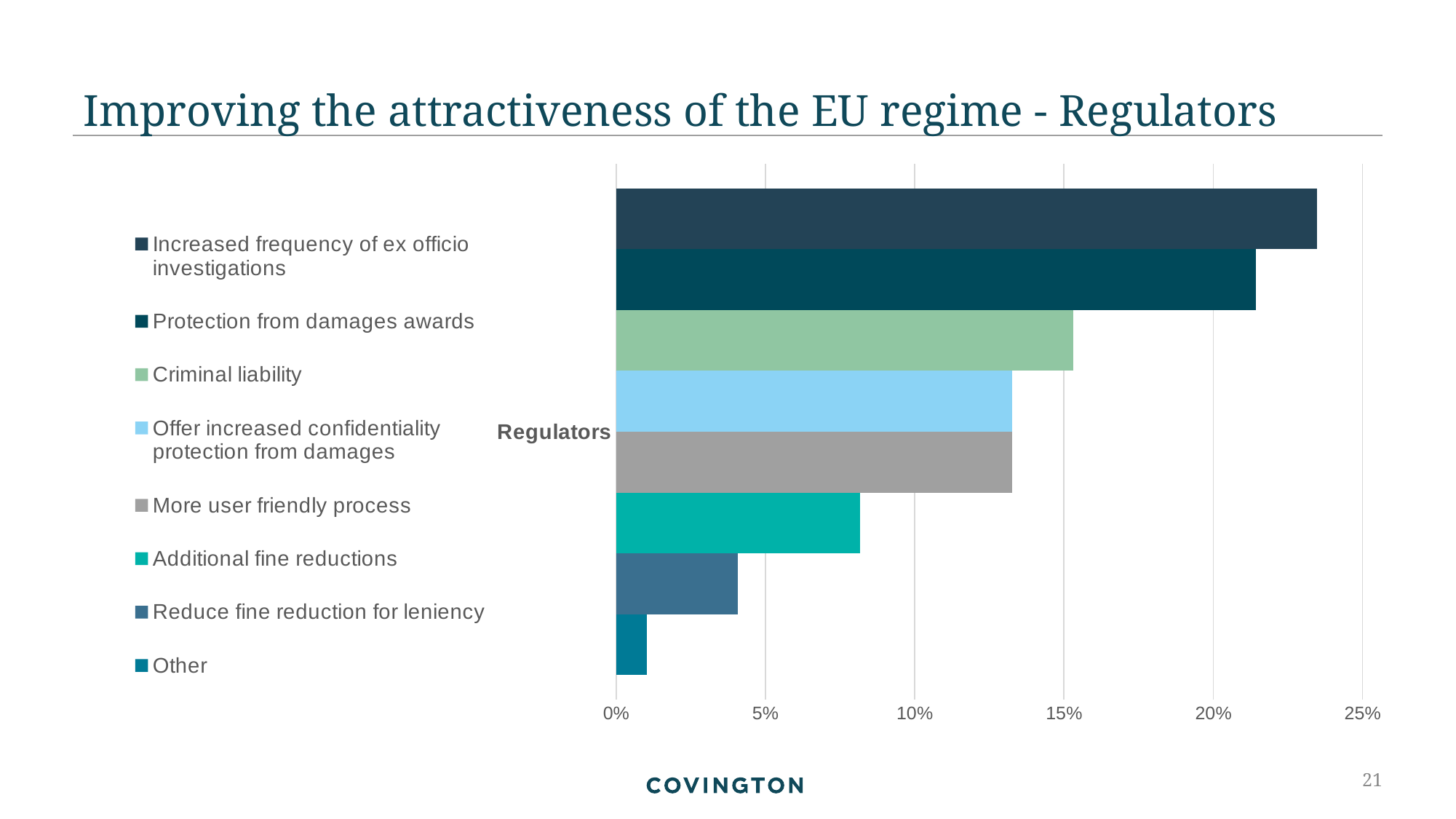
Which series has the longest bar? Increased frequency of ex officio investigations Is the value for Reduce fine reduction for leniency greater or less than 5%? less What is the highest value shown on the horizontal axis? 25% Which series has the shortest bar? Other Is the value for Additional fine reductions greater or less than 10%? less What is the category label shown on the vertical axis of the chart? Regulators Is the value for Increased frequency of ex officio investigations greater or less than 20%? greater What kind of chart is shown on the slide? bar chart Which is larger, the value for Criminal liability or the value for Additional fine reductions? Criminal liability How many series does the legend list? 8